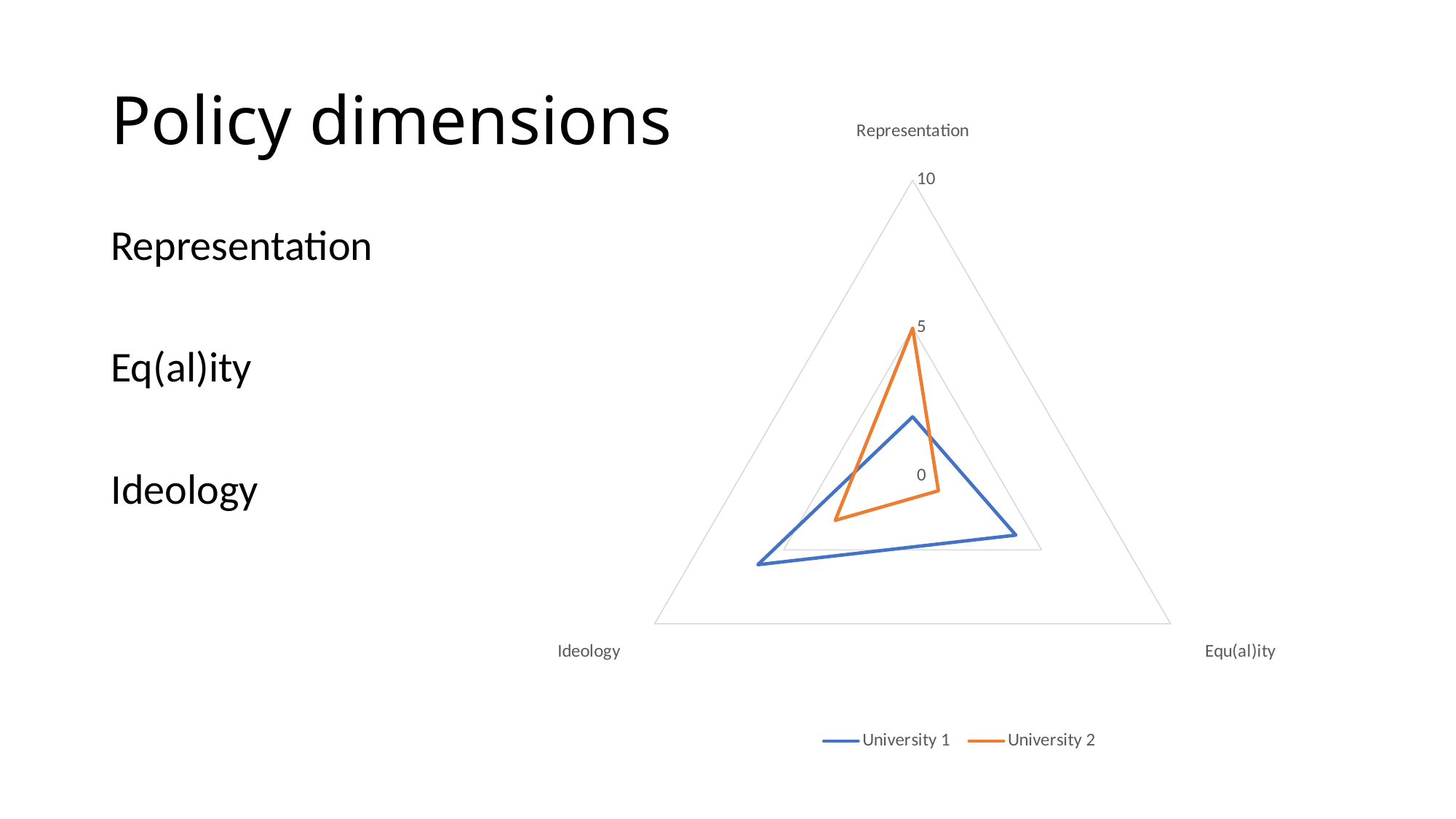
What is the value for University 2 on the Representation axis? 5 Which series has the higher value on the Ideology axis, University 1 or University 2? University 1 How many axes (categories) does the radar chart have? 3 Is the value for University 1 on the Representation axis greater or less than 5? less On which axis does University 1 have its highest value? Ideology What kind of chart is shown on the slide? Radar chart Is the value for University 1 on the Ideology axis greater or less than 5? greater Which series has the higher value on the Representation axis, University 1 or University 2? University 2 Is the value for University 2 on the Equ(al)ity axis greater or less than 5? less How many series does the chart legend list? 2 What colour is the line for University 2 in the chart? Orange On which axis does University 2 have its lowest value? Equ(al)ity